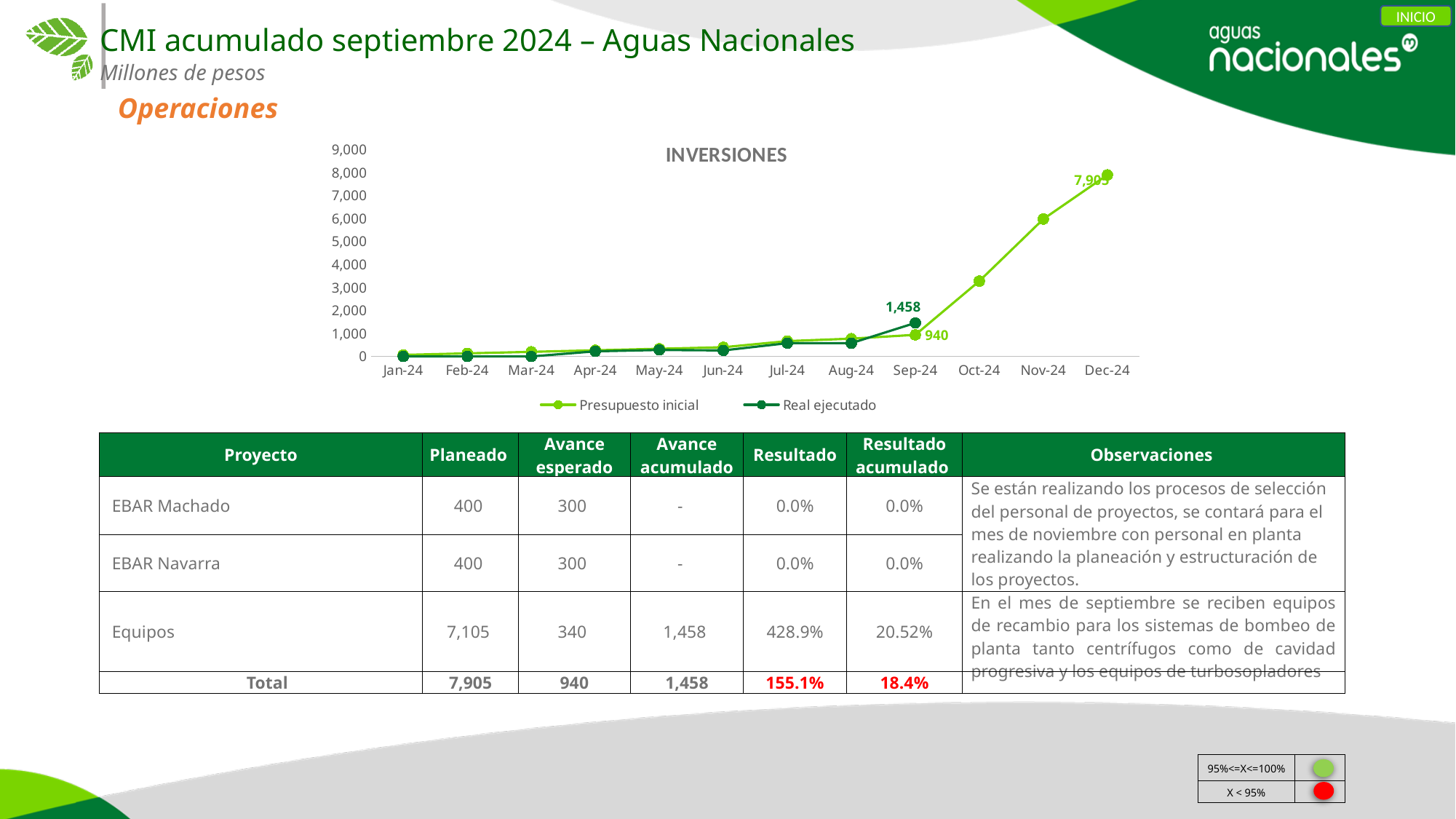
What is the value of Presupuesto inicial at Dec-24 in the INVERSIONES chart? 7,905 In the INVERSIONES chart, is the value of Presupuesto inicial at Nov-24 greater or less than 5,000? greater In the INVERSIONES chart, what is the difference between Real ejecutado and Presupuesto inicial at Sep-24? 518 What is the value of Real ejecutado at Sep-24 in the INVERSIONES chart? 1,458 In the INVERSIONES chart, does the Presupuesto inicial line rise or fall from Sep-24 to Dec-24? rise How many series does the legend of the INVERSIONES chart list? 2 In the INVERSIONES chart, is the value of Presupuesto inicial at Oct-24 greater or less than 4,000? less What is the value of Presupuesto inicial at Sep-24 in the INVERSIONES chart? 940 How many months are shown on the x axis of the INVERSIONES chart? 12 In the INVERSIONES chart, which series has the larger value at Sep-24, Presupuesto inicial or Real ejecutado? Real ejecutado In which month does the Presupuesto inicial series reach its highest value in the INVERSIONES chart? Dec-24 What kind of chart is the INVERSIONES chart? line chart